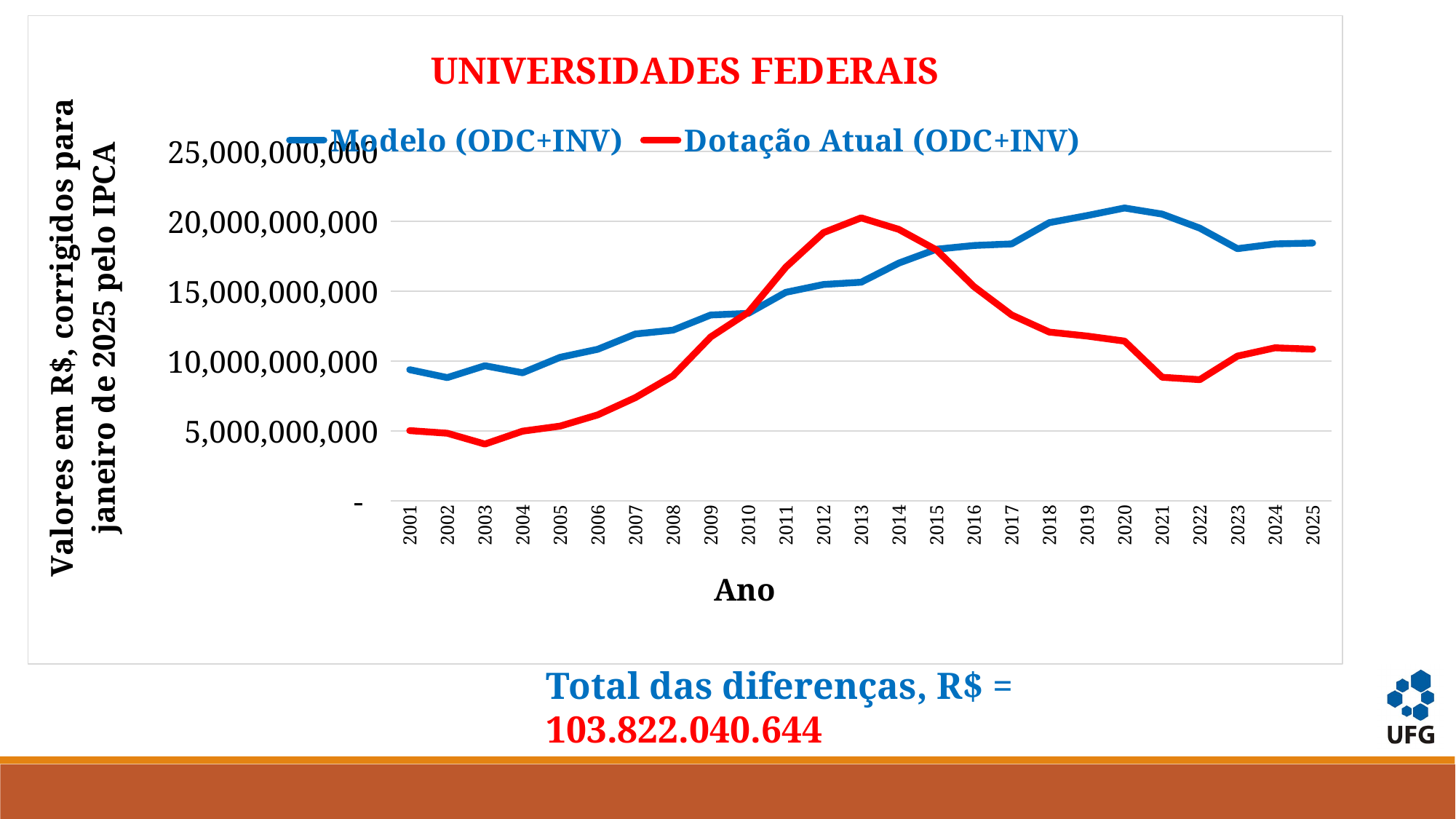
In which year does the Dotação Atual (ODC+INV) series reach its highest value? 2013 In which year does the Dotação Atual (ODC+INV) series reach its lowest value? 2003 Does the Dotação Atual (ODC+INV) series rise or fall from 2013 to 2022? fall Which series is drawn in red? Dotação Atual (ODC+INV) What is the title of the chart? UNIVERSIDADES FEDERAIS In which year does the Modelo (ODC+INV) series reach its highest value? 2020 Is the value for Dotação Atual (ODC+INV) in 2003 greater or less than 5,000,000,000? less How many series does the legend list? 2 Which series has the larger value in 2013, Modelo (ODC+INV) or Dotação Atual (ODC+INV)? Dotação Atual (ODC+INV) How many years are plotted along the x axis? 25 What kind of chart is shown on the slide? line chart Is the value for Modelo (ODC+INV) in 2020 greater or less than 20,000,000,000? greater